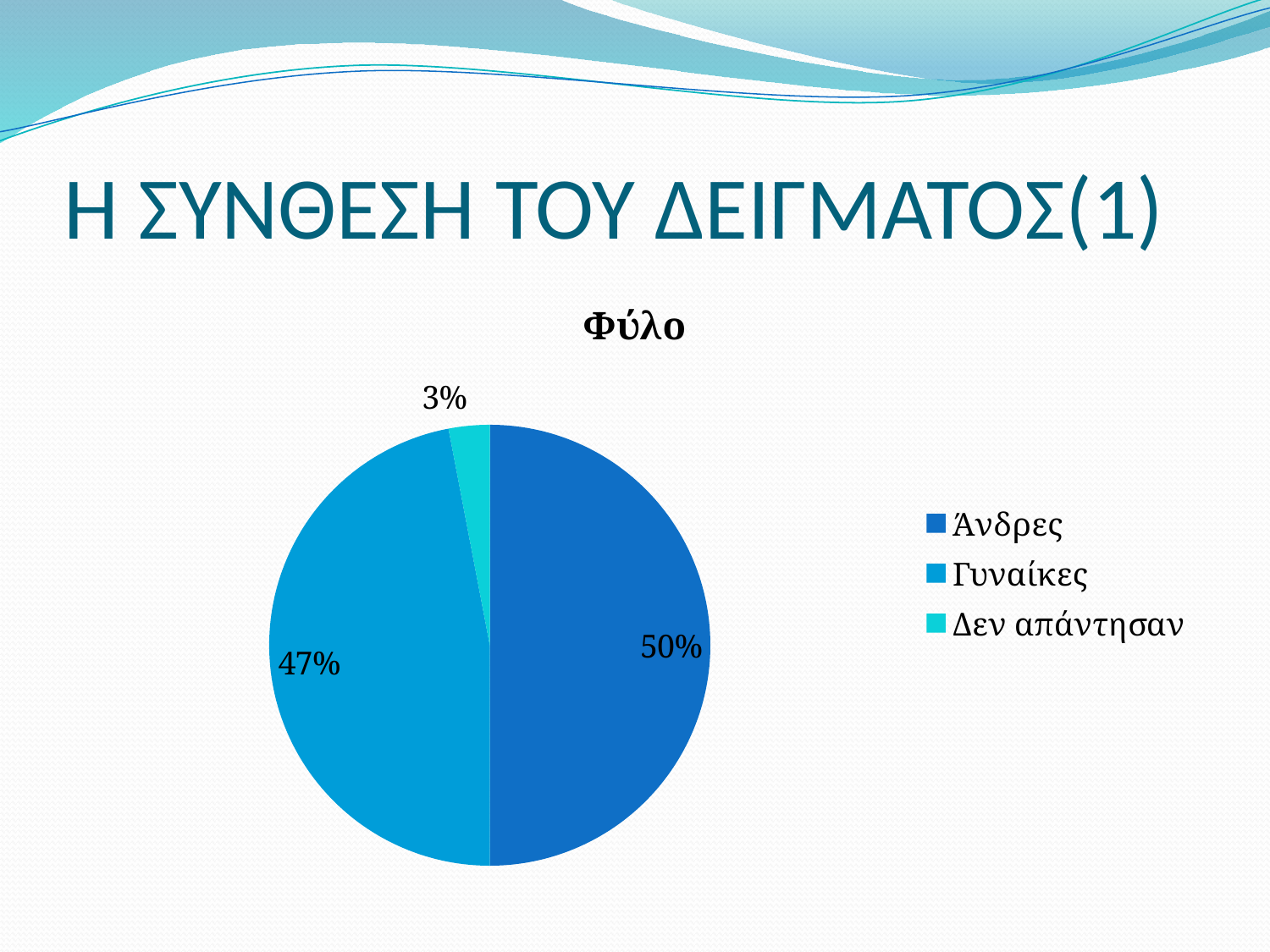
What is the difference in percentage points between Γυναίκες and Δεν απάντησαν? 44 Which is larger, the share for Γυναίκες or the share for Δεν απάντησαν? Γυναίκες What is the title of the chart? Φύλο What type of chart is shown on the slide? pie chart What is the difference in percentage points between Άνδρες and Γυναίκες? 3 What percentage of the pie is Δεν απάντησαν? 3% Which category has the smallest share of the pie? Δεν απάντησαν Which category has the largest share of the pie? Άνδρες What percentage of the pie is Γυναίκες? 47% How many categories does the legend list? 3 Which legend entry is shown in the lightest (cyan) colour? Δεν απάντησαν What percentage of the pie is Άνδρες? 50%